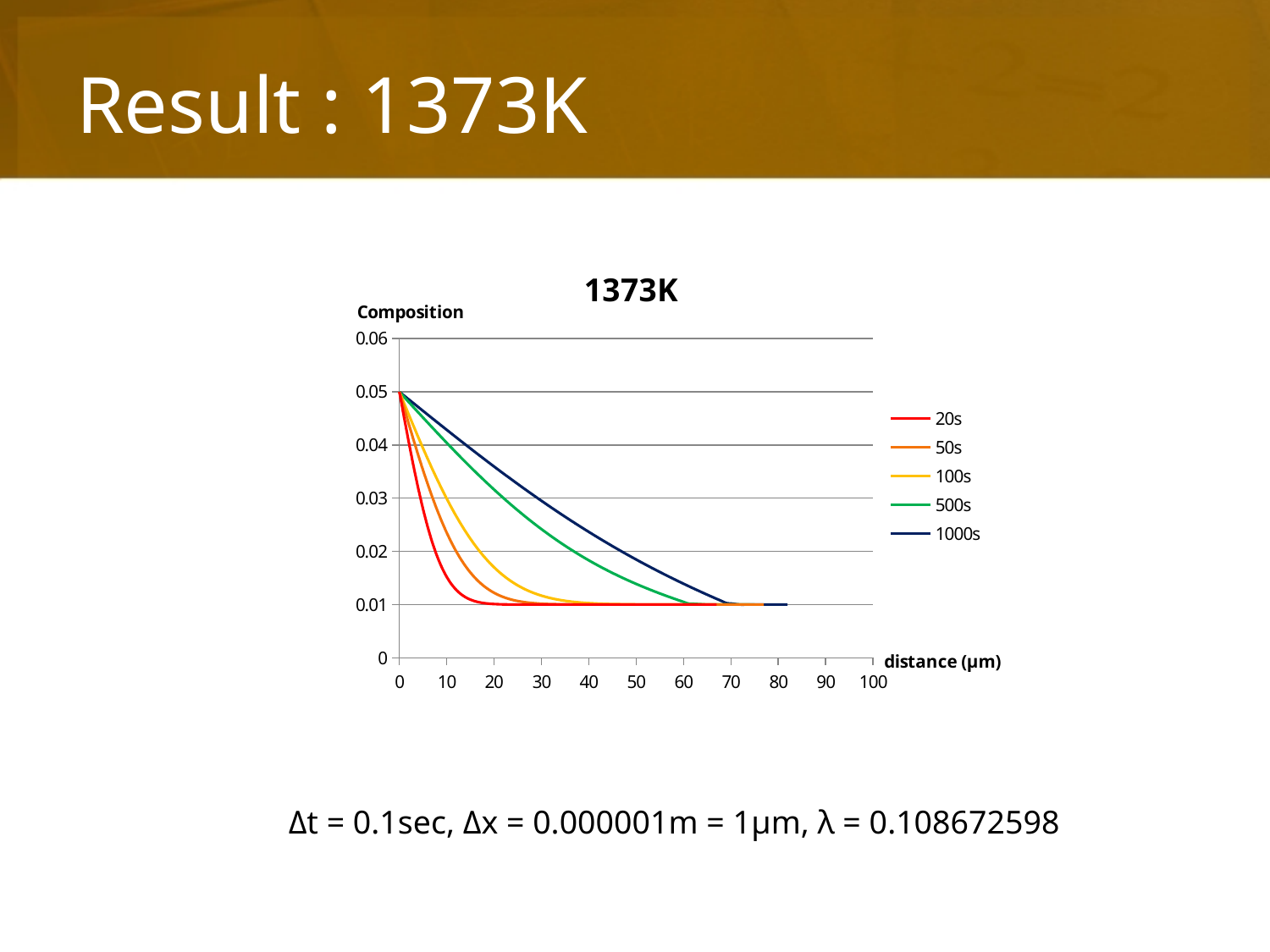
How many series does the legend list? 5 At a distance of 30 μm, which series has the higher composition, 1000s or 100s? 1000s Which series keeps a composition above 0.01 out to the greatest distance? 1000s What kind of chart is shown on the slide? line chart Do the composition values rise or fall as distance increases? fall Which series drops to the 0.01 level at the shortest distance? 20s What is the label of the x axis? distance (μm) What is the title of the chart? 1373K Is the composition for the 20s series at a distance of 40 μm greater or less than 0.02? less What composition value do all the curves start at when distance is 0? 0.05 What composition value do the curves level off at for large distances? 0.01 Is the composition for the 1000s series at a distance of 20 μm greater or less than 0.03? greater